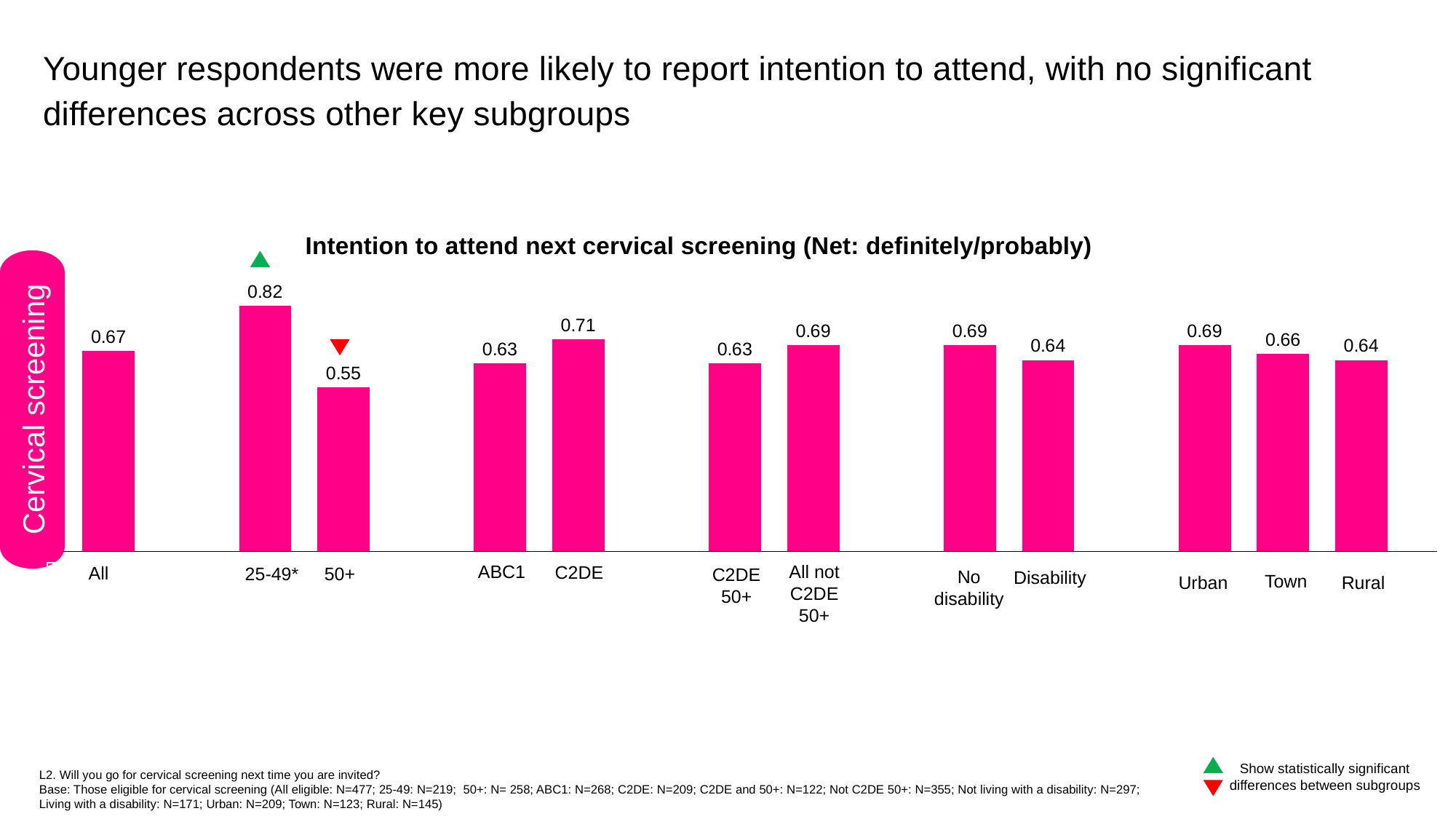
Which category has the lowest value? 50+ What is the value for the All group? 0.67 What is the value for the 50+ group? 0.55 What is the difference between the values for 25-49* and 50+? 0.27 Which is larger, the value for ABC1 or the value for C2DE? C2DE Which category has the highest value? 25-49* What is the title of the chart? Intention to attend next cervical screening (Net: definitely/probably) What type of chart is shown on the slide? Bar chart What is the value for C2DE? 0.71 What is the value for the 25-49* group? 0.82 What is the value for Town? 0.66 How many bars are shown in the chart? 12